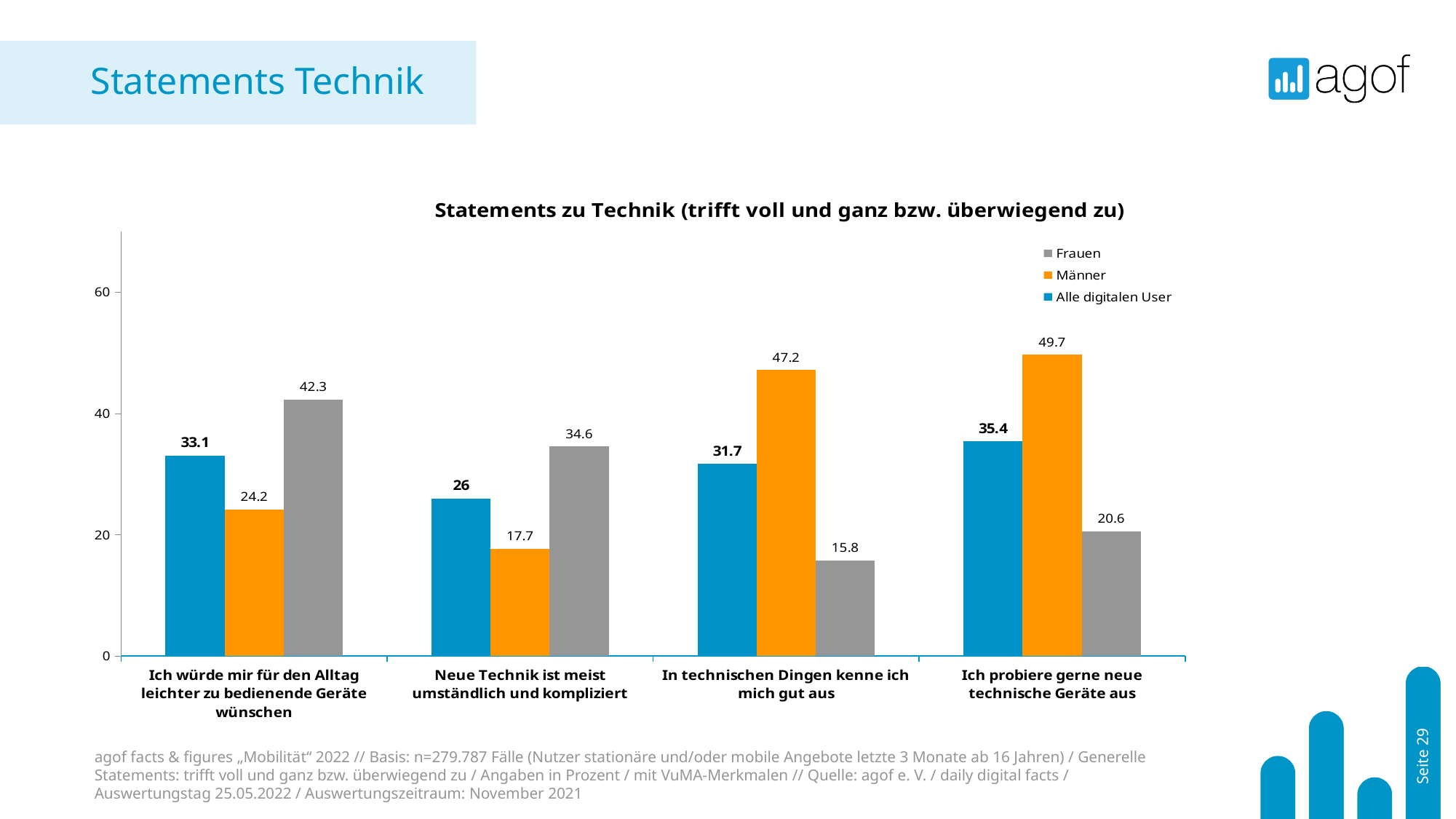
How many statements are shown on the x axis? 4 What is the difference between the Männer and Frauen values for "Ich probiere gerne neue technische Geräte aus"? 29.1 What is the value for Frauen for the statement "Ich würde mir für den Alltag leichter zu bedienende Geräte wünschen"? 42.3 What is the value for Alle digitalen User for the statement "Neue Technik ist meist umständlich und kompliziert"? 26 What is the value for Männer for the statement "In technischen Dingen kenne ich mich gut aus"? 47.2 Is the value for Männer for "Ich probiere gerne neue technische Geräte aus" greater or less than 40? greater Which statement has the highest value for Männer? Ich probiere gerne neue technische Geräte aus How many series does the legend list? 3 Which statement has the lowest value for Frauen? In technischen Dingen kenne ich mich gut aus For the statement "Neue Technik ist meist umständlich und kompliziert", which is larger: the value for Frauen or for Männer? Frauen What is the title of the chart? Statements zu Technik (trifft voll und ganz bzw. überwiegend zu) What kind of chart is shown? Bar chart